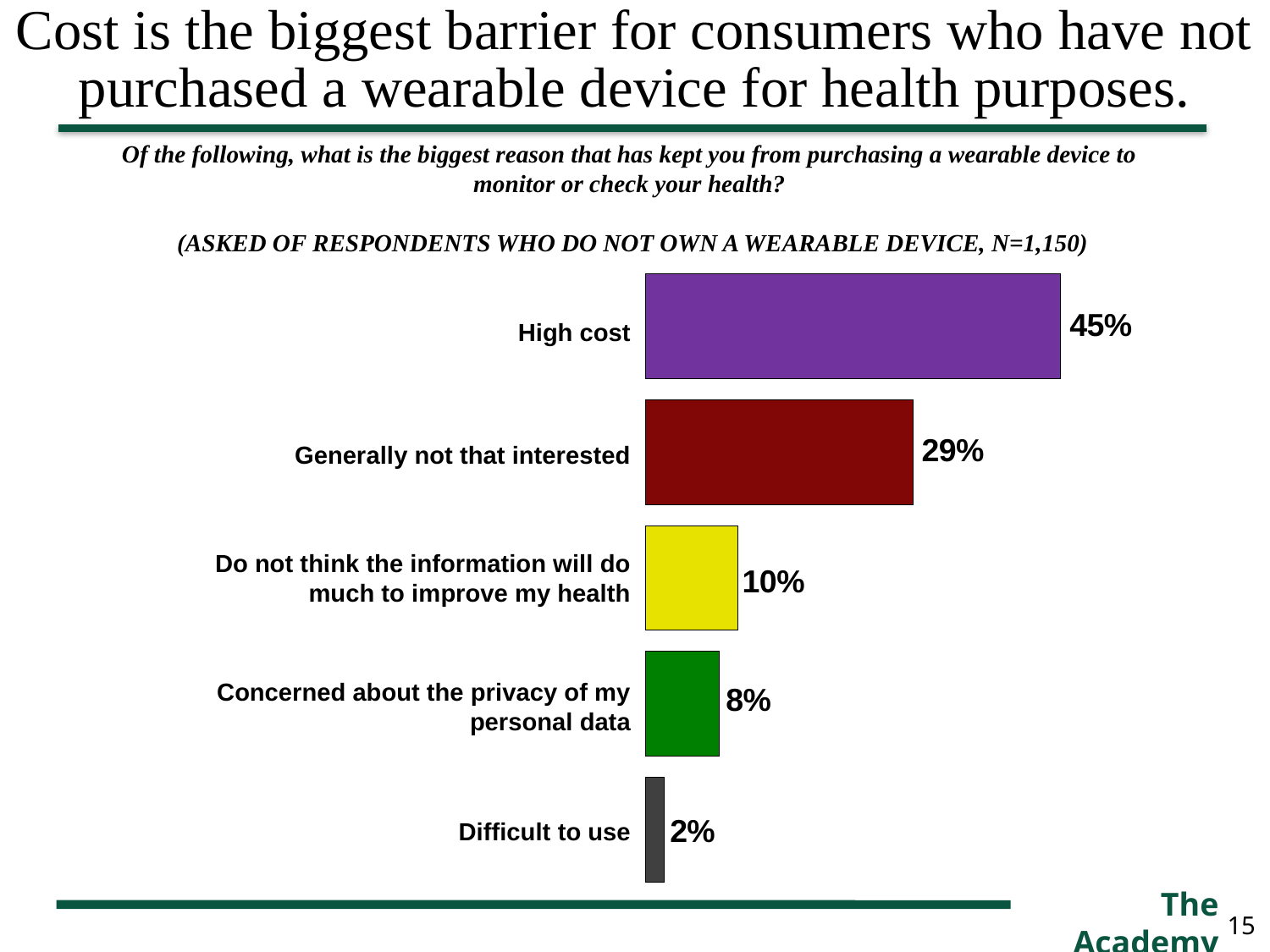
Which reason has the lowest percentage? Difficult to use What is the value for "Concerned about the privacy of my personal data"? 8% Which is larger: the value for "Concerned about the privacy of my personal data" or the value for "Difficult to use"? Concerned about the privacy of my personal data Which reason has the highest percentage? High cost What percentage of respondents said the device is "Difficult to use"? 2% What is the difference in percentage points between "High cost" and "Generally not that interested"? 16 What percentage of respondents cited "High cost" as the biggest reason for not purchasing a wearable device? 45% What is the value shown for "Generally not that interested"? 29% What percentage is shown for "Do not think the information will do much to improve my health"? 10% How many reasons (categories) are shown in the chart? 5 What colour is the bar for "High cost"? Purple What kind of chart is shown on the slide? Bar chart